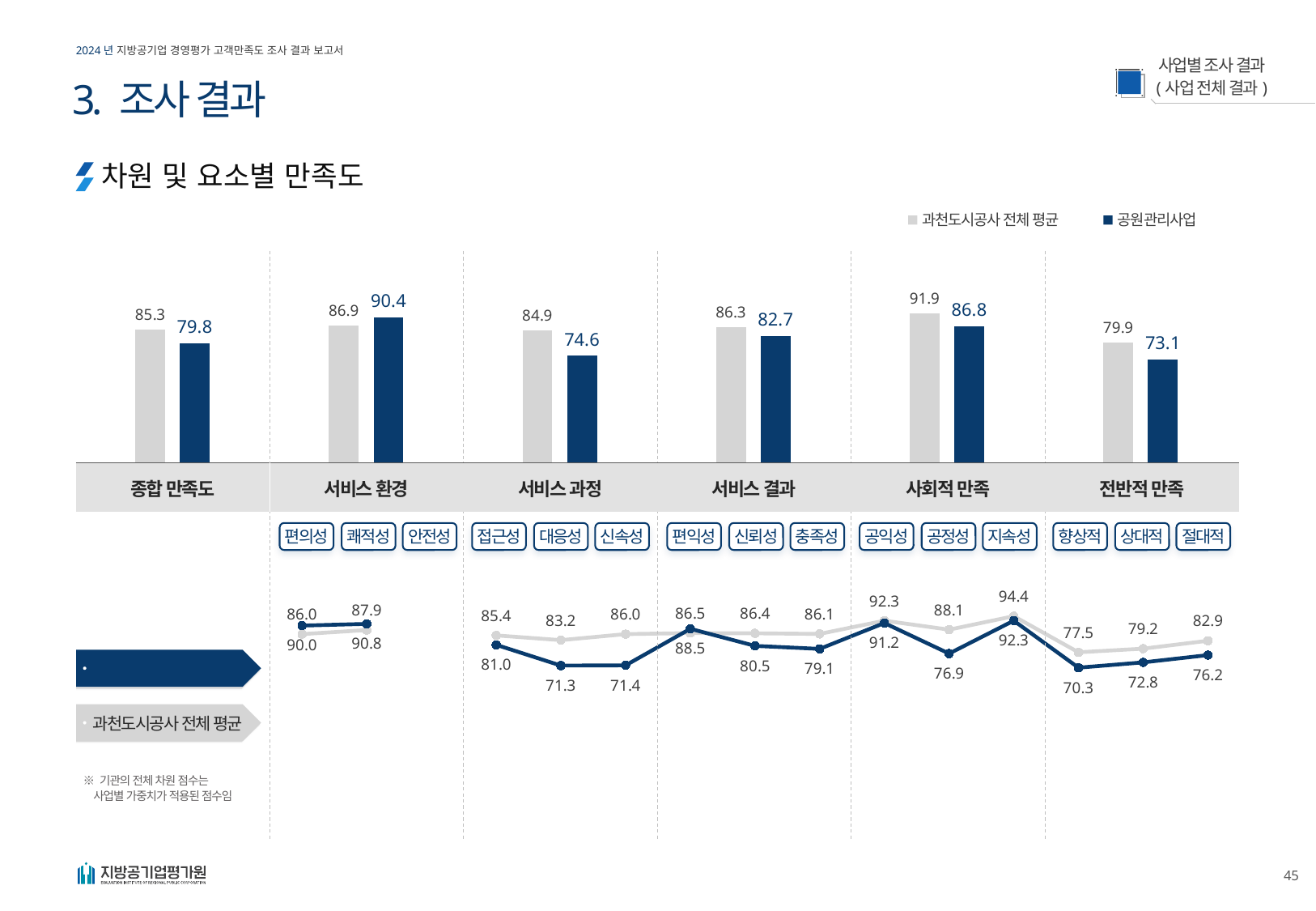
How many series does the legend of the top chart list? 2 In the top bar chart, what is the difference between the 과천도시공사 전체 평균 and 공원관리사업 values for 서비스 과정? 10.3 How many categories are shown in the top bar chart? 6 In the bottom line chart, what is the difference between the 과천도시공사 전체 평균 and 공원관리사업 values for 대응성? 11.9 In the top bar chart, what is the 공원관리사업 value for 서비스 환경? 90.4 In the top bar chart, for 종합 만족도, which is larger: 과천도시공사 전체 평균 or 공원관리사업? 과천도시공사 전체 평균 What kind of chart is the top chart on the slide? bar chart In the top bar chart, which category has the highest 공원관리사업 value? 서비스 환경 In the top bar chart, which category has the lowest 과천도시공사 전체 평균 value? 전반적 만족 In the top bar chart, what is the 과천도시공사 전체 평균 value for 사회적 만족? 91.9 In the bottom line chart, what is the 공원관리사업 value for 공정성? 76.9 In the bottom line chart, what is the 과천도시공사 전체 평균 value for 지속성? 94.4